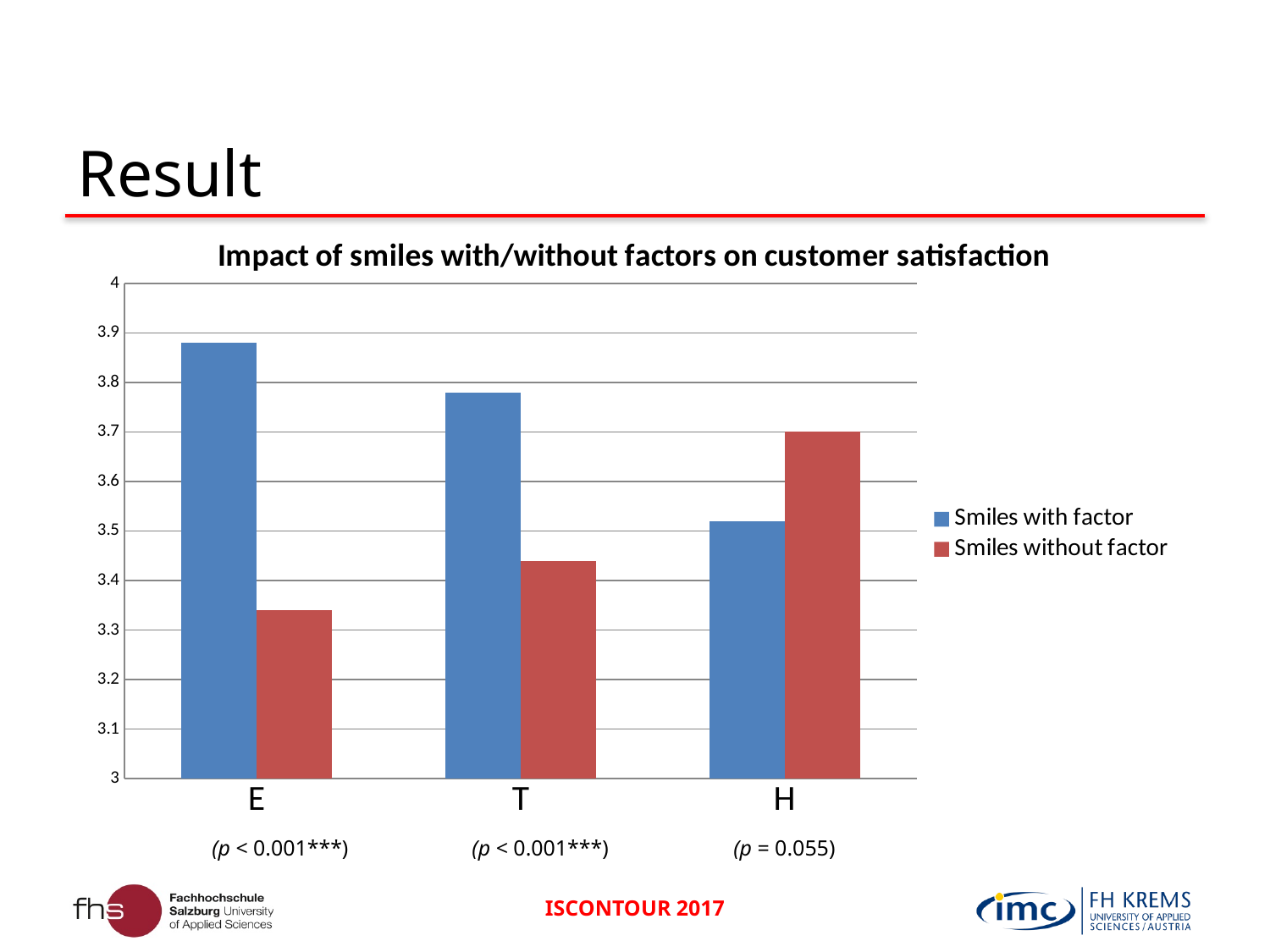
How many categories are shown on the x axis? 3 For category E, which is larger: Smiles with factor or Smiles without factor? Smiles with factor What kind of chart is shown on the slide? bar chart Which category has the highest value for Smiles with factor? E Do the values for Smiles with factor rise or fall from E to H along the x axis? fall Which category has the lowest value for Smiles without factor? E For category H, which is larger: Smiles with factor or Smiles without factor? Smiles without factor Which category has the lowest value for Smiles with factor? H Is the value for Smiles with factor in category E greater or less than 3.8? greater How many series does the legend list? 2 Is the value for Smiles without factor in category T greater or less than 3.5? less Which category has the highest value for Smiles without factor? H